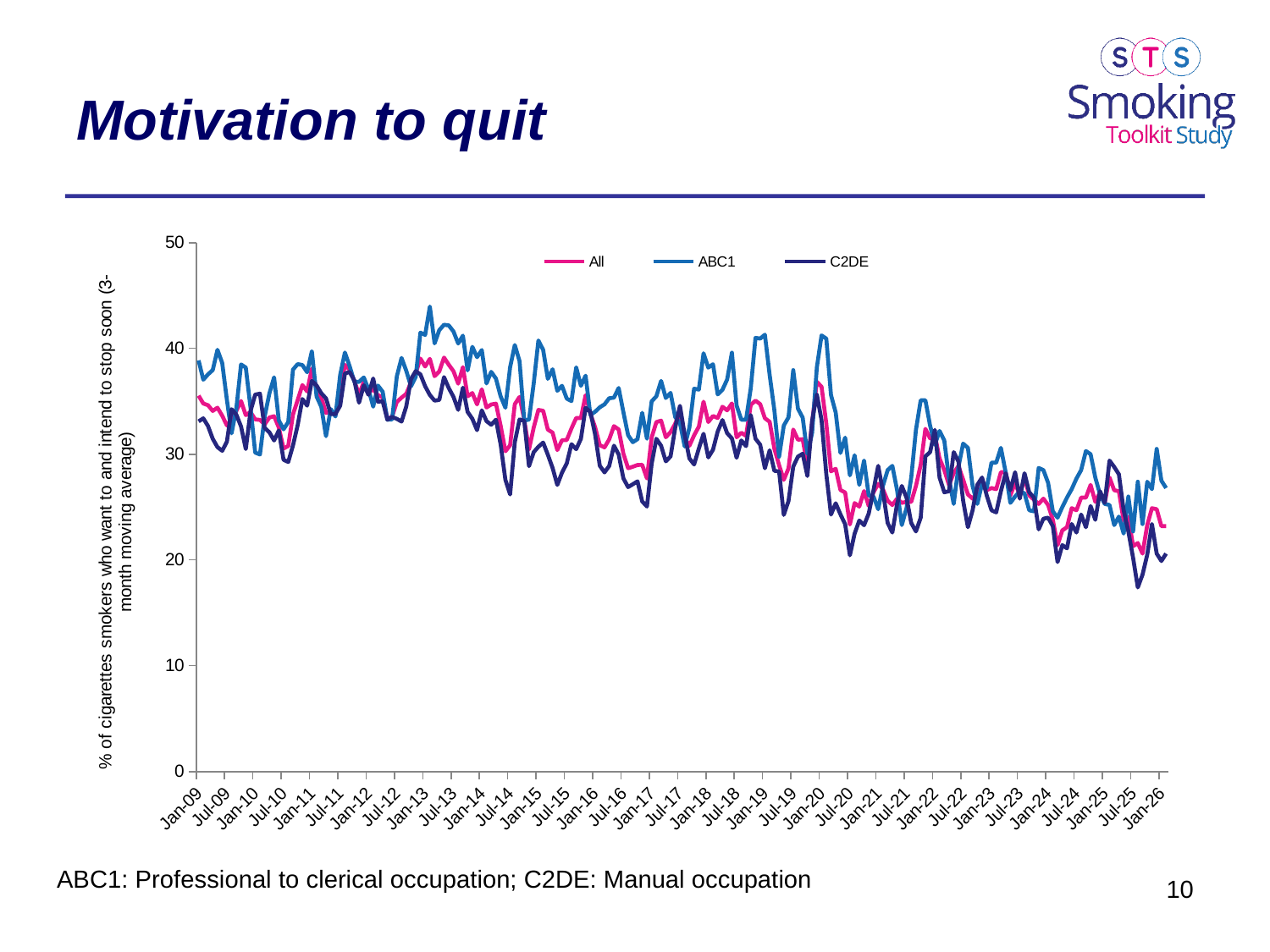
Around Jan-13, which series has the higher value, ABC1 or C2DE? ABC1 Which series are listed in the chart legend? All, ABC1, C2DE Is the value for All at Jan-26 greater or less than 30? less Is the value for All at Jan-09 greater or less than 30? greater Is the value for C2DE around Jan-24 greater or less than 30? less How many series does the legend list? 3 What is the title of the slide containing the chart? Motivation to quit Around Jul-25, which series has the higher value, ABC1 or C2DE? ABC1 What kind of chart is shown on the slide? Line chart Overall, do the values for the All series rise or fall from Jan-09 to Jan-26? Fall